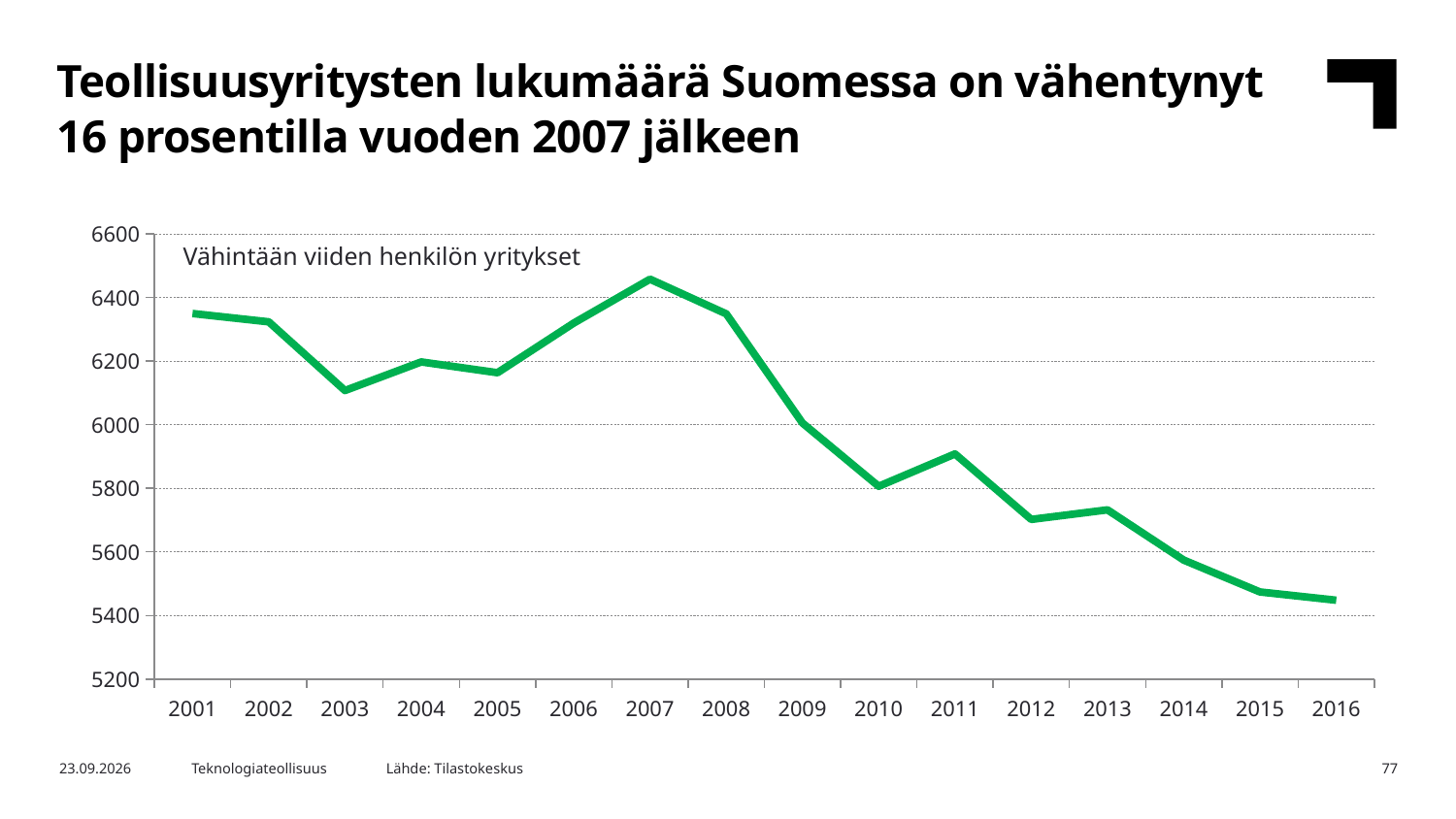
Which year has the highest value on the chart? 2007 Which is larger, the value for 2007 or the value for 2016? 2007 What text label is shown inside the plot area of the chart? Vähintään viiden henkilön yritykset Which is larger, the value for 2011 or the value for 2012? 2011 How many years are plotted along the x axis? 16 What kind of chart is shown on the slide? Line chart Is the value for 2016 greater or less than 5600? less Is the value for 2012 greater or less than 5800? less Is the value for 2003 greater or less than 6200? less Overall, do the values rise or fall from 2007 to 2016? fall